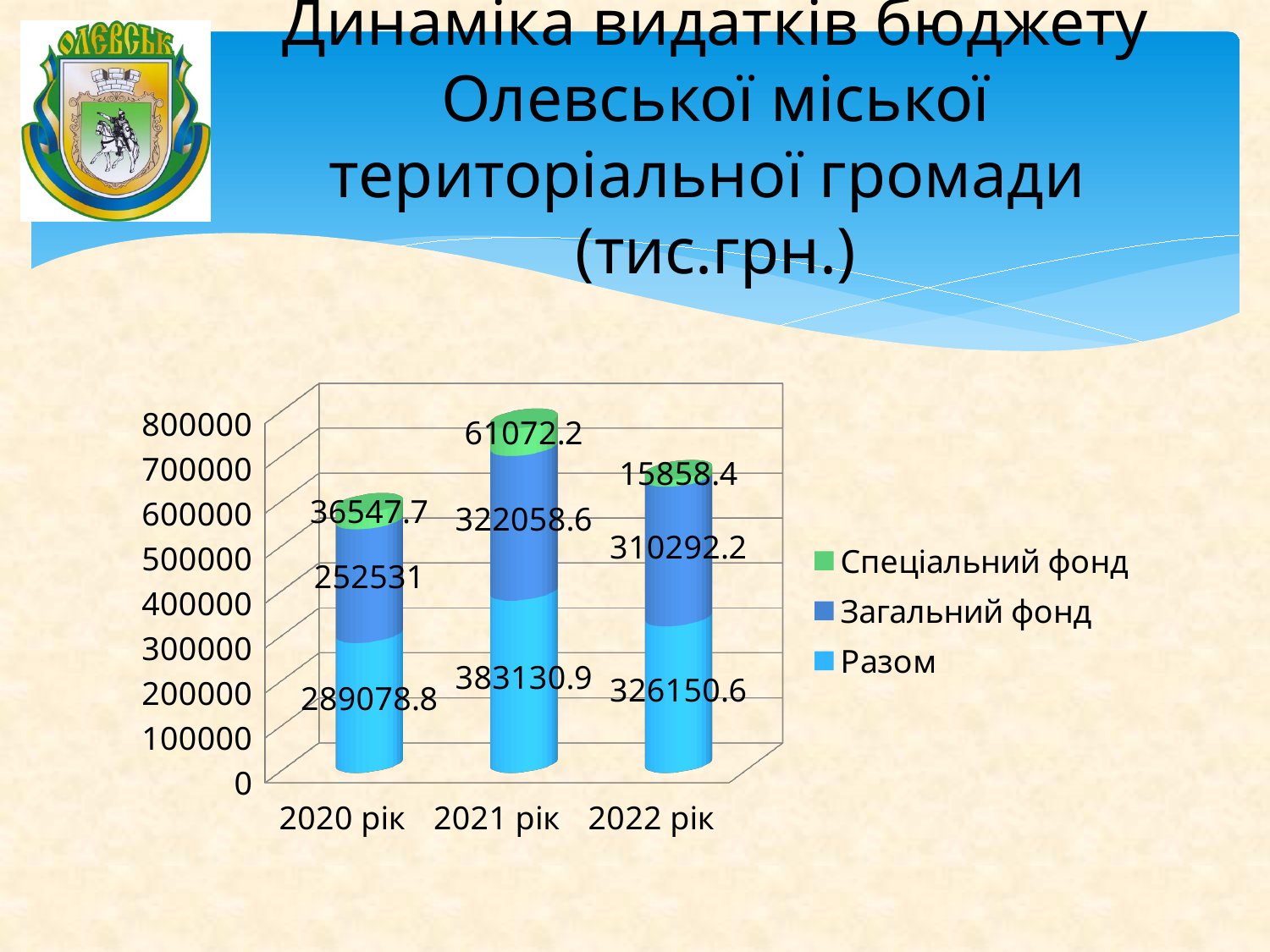
What is the value of Разом for 2021 рік? 383130.9 Which is larger: Загальний фонд for 2021 рік or for 2022 рік? 2021 рік How many year categories are shown on the x axis? 3 What is the difference between Разом for 2021 рік and 2020 рік? 94052.1 What is the value of Загальний фонд for 2022 рік? 310292.2 How many series does the legend list? 3 Which series is shown in green in the legend? Спеціальний фонд What type of chart is shown on the slide? Stacked bar chart In which year is Спеціальний фонд the highest? 2021 рік In which year is Разом the lowest? 2020 рік What is the value of Спеціальний фонд for 2020 рік? 36547.7 What is the total height of the stacked bar for 2022 рік? 652301.2